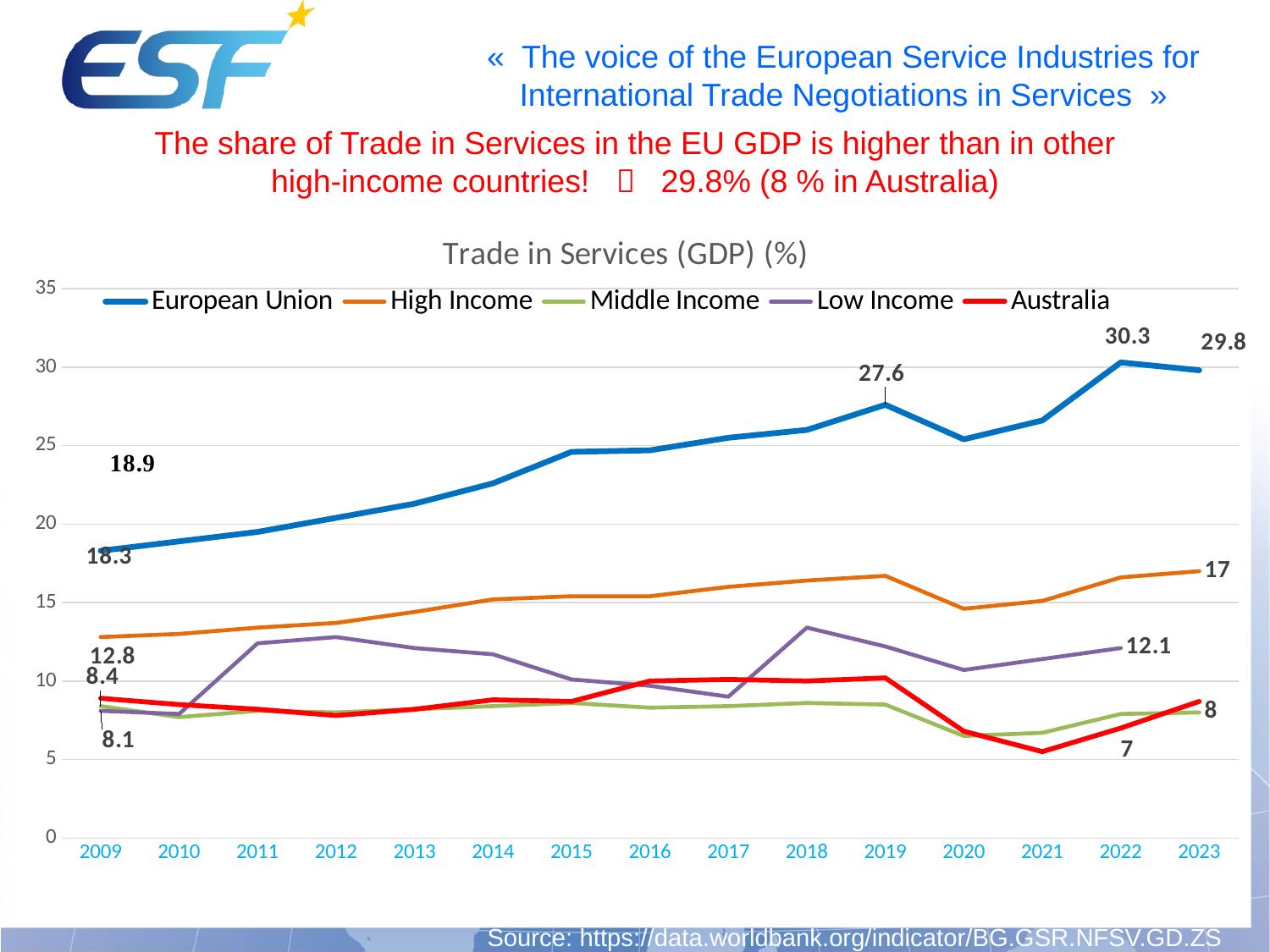
In 2018, which is larger: High Income or Low Income? High Income Which series has the highest value in 2023? European Union What is the value for the European Union in 2019? 27.6 What is the value for the European Union in 2022? 30.3 What is the value for High Income in 2023? 17 What is the value for the European Union in 2023? 29.8 Is the value for the European Union in 2015 greater or less than 20? greater What is the value for Low Income in 2022? 12.1 By how much did the European Union value change from 2022 to 2023? 0.5 How many series does the legend list? 5 What is the difference between the European Union and High Income values in 2023? 12.8 What kind of chart is shown on the slide? Line chart